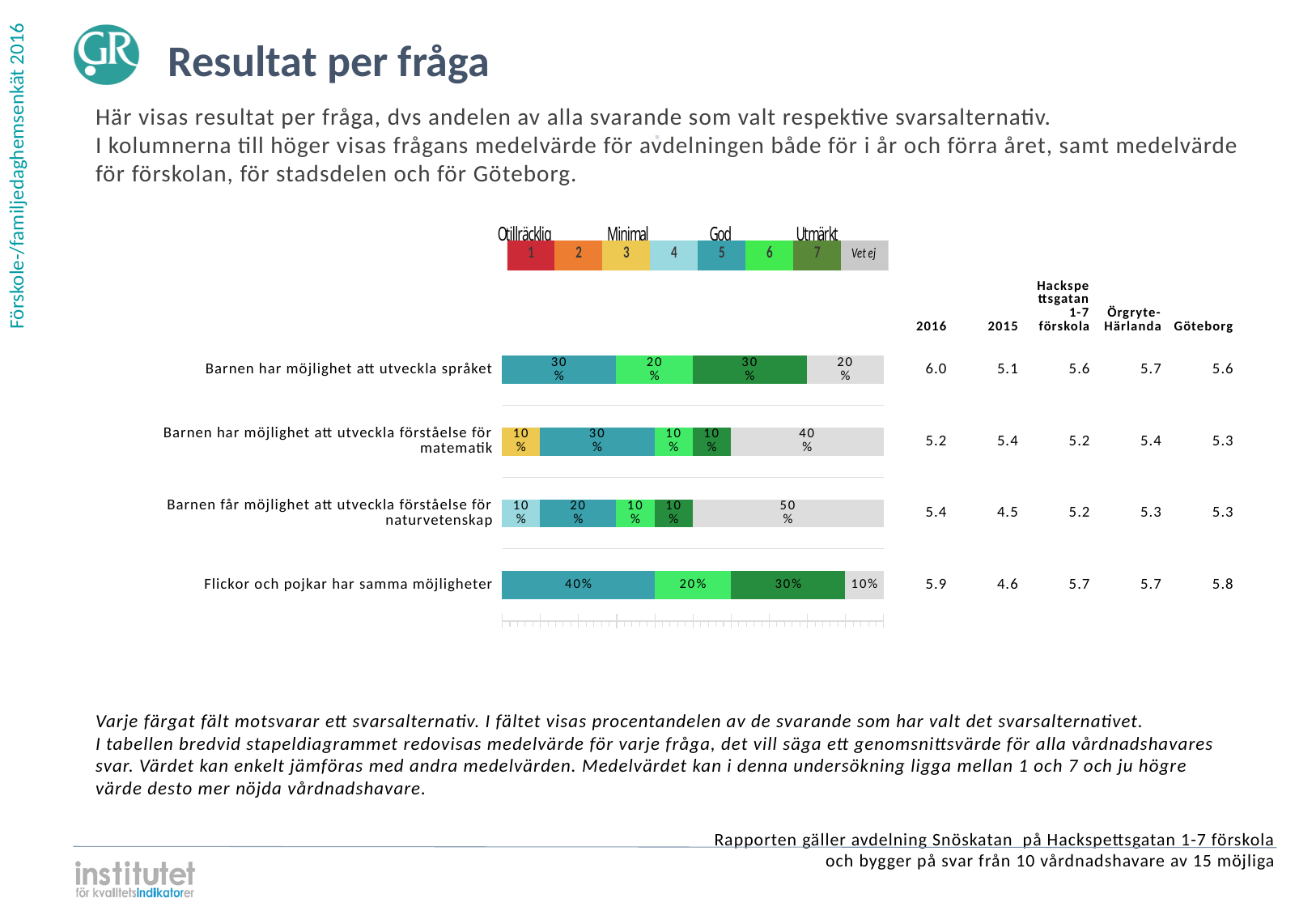
Is the option 5 share larger for "Flickor och pojkar har samma möjligheter" or for "Barnen får möjlighet att utveckla förståelse för naturvetenskap"? Flickor och pojkar har samma möjligheter How many questions (categories) are plotted in the bar chart? 4 What is the 2015 mean value shown for "Flickor och pojkar har samma möjligheter"? 4.6 What percentage of respondents chose "Vet ej" for "Barnen får möjlighet att utveckla förståelse för naturvetenskap"? 50% What is the difference between the "Vet ej" share for "Barnen har möjlighet att utveckla förståelse för matematik" and for "Flickor och pojkar har samma möjligheter"? 30% How many response options does the legend above the chart list, including "Vet ej"? 8 What is the 2016 mean value shown for "Barnen har möjlighet att utveckla språket"? 6.0 What kind of chart is shown on the slide? stacked bar chart Which question has the smallest "Vet ej" share? Flickor och pojkar har samma möjligheter What percentage of respondents chose option 7 (Utmärkt) for "Barnen har möjlighet att utveckla språket"? 30% Which question has the largest "Vet ej" share? Barnen får möjlighet att utveckla förståelse för naturvetenskap What percentage of respondents chose option 5 for "Flickor och pojkar har samma möjligheter"? 40%